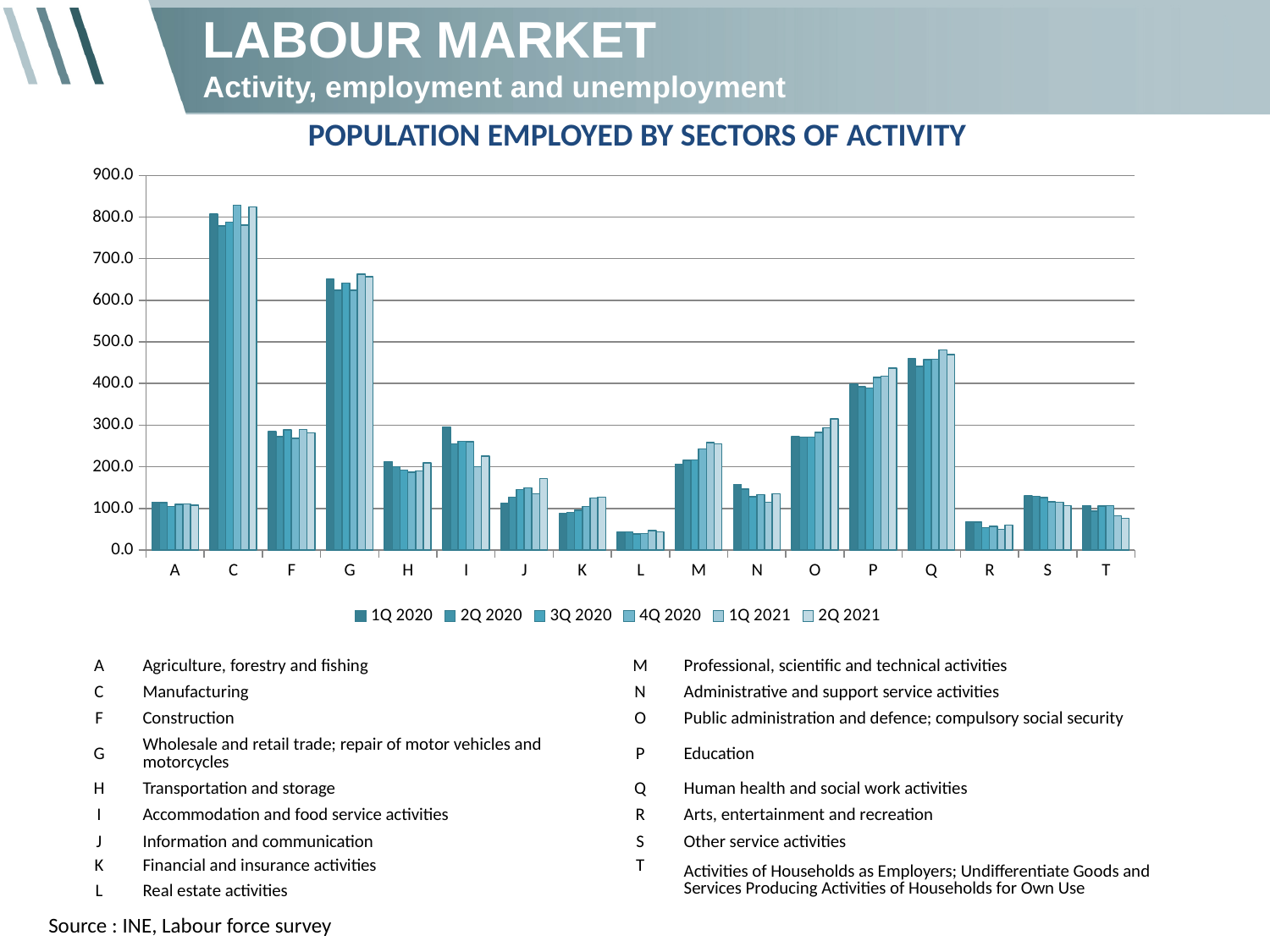
Is the value for C in 1Q 2021 greater or less than 800? less Which is larger in 1Q 2020, the value for O or the value for P? P What type of chart is shown on the slide? bar chart How many sector categories are shown on the x axis? 17 Is the value for Q in 1Q 2021 greater or less than 400? greater Which sector category has the highest employed population? C Is the value for G in 1Q 2020 greater or less than 600? greater Which is larger in 2Q 2021, the value for R or the value for S? S How many series does the legend list? 6 What is the title of the chart? POPULATION EMPLOYED BY SECTORS OF ACTIVITY Which sector category has the lowest employed population? L